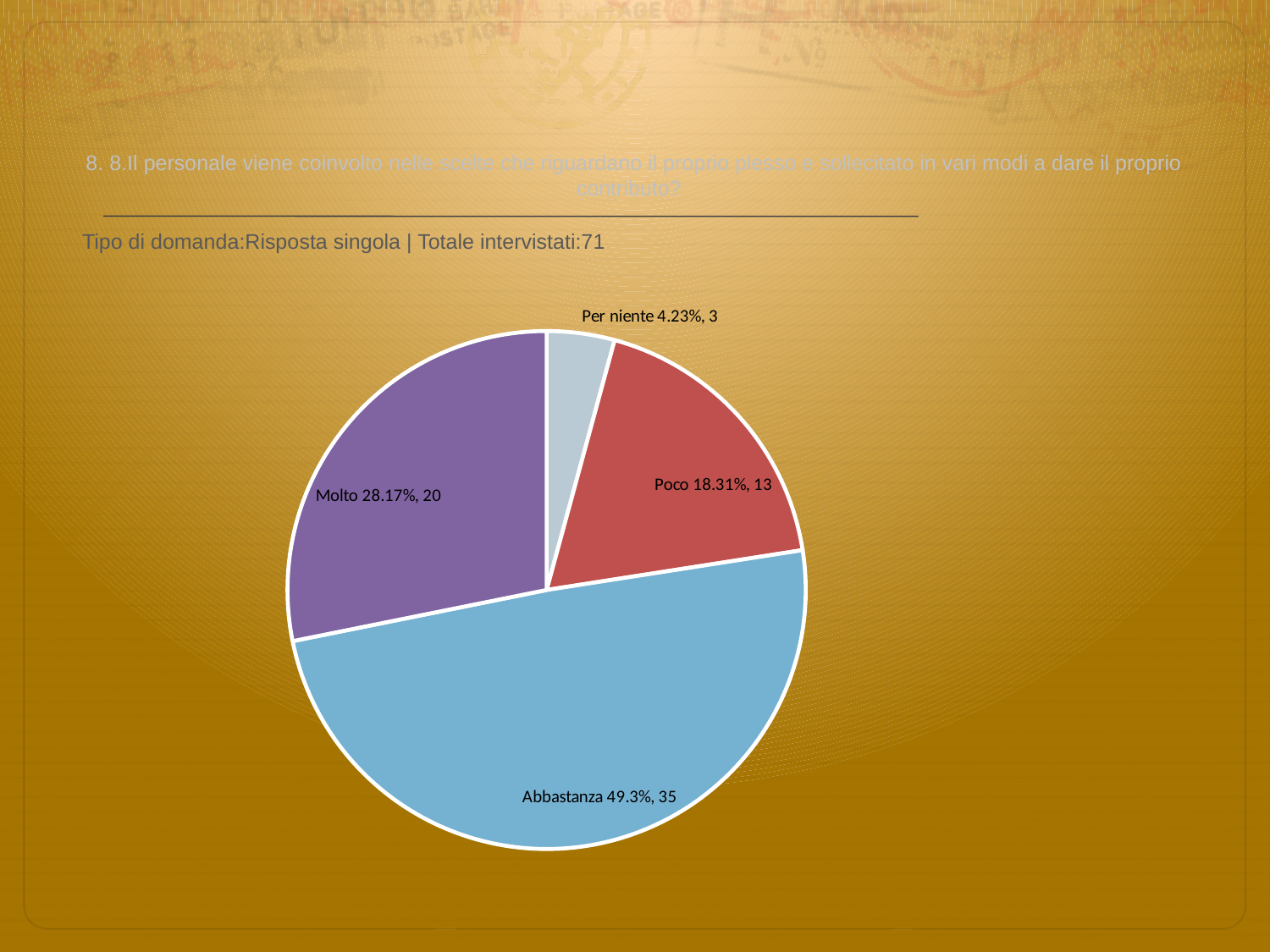
What percentage share does the Poco slice have? 18.31% What colour is the Abbastanza slice? blue What is the total number of respondents across all slices? 71 What kind of chart is shown on the slide? pie chart How many respondents answered Per niente? 3 How many slices does the pie chart have? 4 What is the difference in respondent count between Abbastanza and Molto? 15 Which has more respondents, Poco or Molto? Molto Which category has the largest slice? Abbastanza How many respondents answered Molto? 20 Which category has the smallest slice? Per niente What percentage share does the Abbastanza slice have? 49.3%